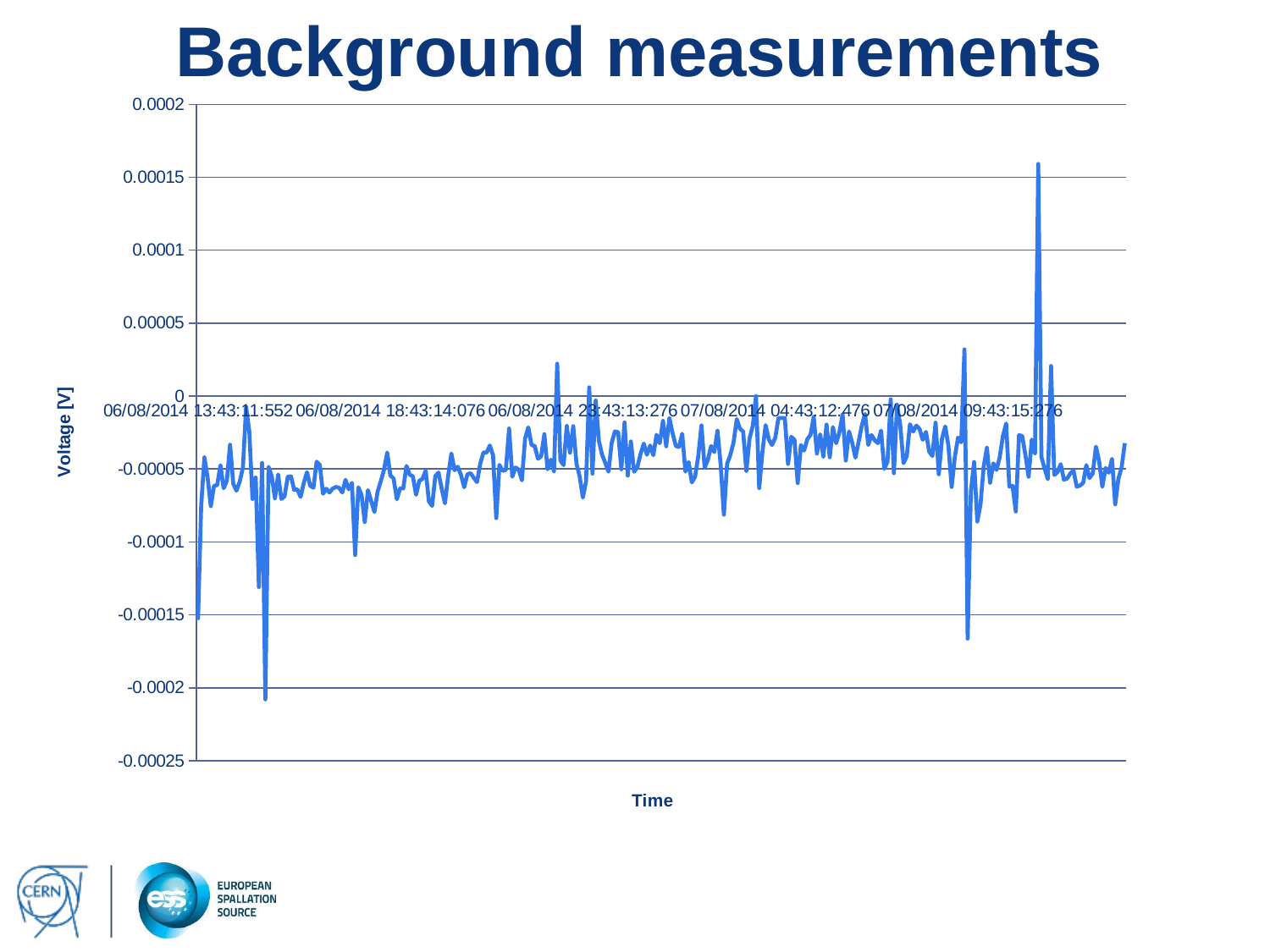
What kind of chart is shown on the slide? line chart Is the highest peak of the line greater or less than 0.0001? greater What is the highest value shown on the vertical axis? 0.0002 What is the first time label shown on the horizontal axis? 06/08/2014 13:43:11:552 What is the label of the vertical axis? Voltage [V] What is the last time label shown on the horizontal axis? 07/08/2014 09:43:15:276 Do most of the plotted values lie above or below 0? below Is the lowest point of the line greater or less than -0.0002? less What is the lowest value shown on the vertical axis? -0.00025 What is the title of the chart? Background measurements